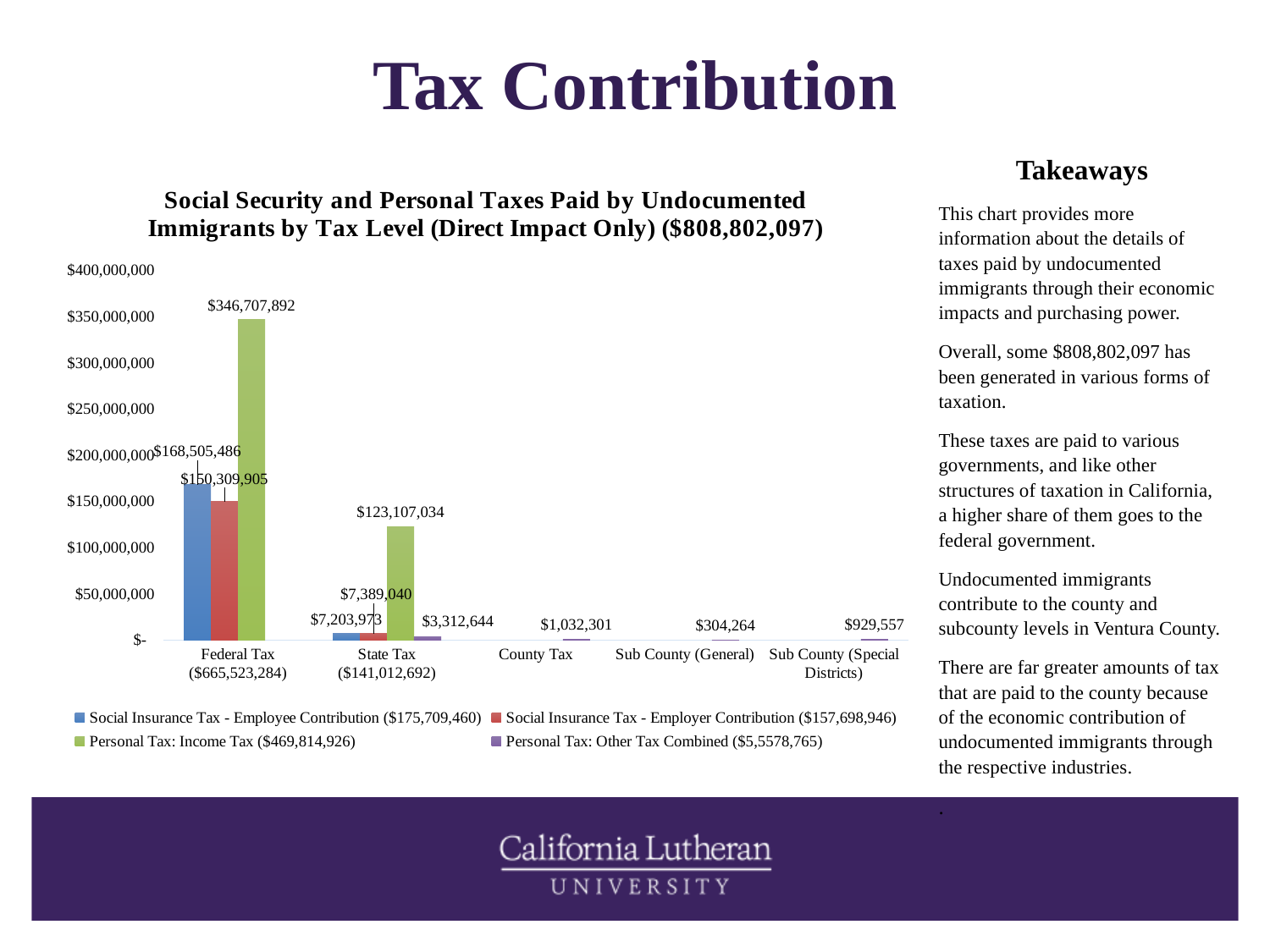
What is the difference between the Personal Tax: Income Tax and the Social Insurance Tax - Employee Contribution values for Federal Tax? $178,202,406 What value is labelled for County Tax? $1,032,301 Is the Personal Tax: Income Tax value for State Tax greater or less than $150,000,000? less What is the Social Insurance Tax - Employer Contribution value for State Tax? $7,389,040 What is the Social Insurance Tax - Employee Contribution value for Federal Tax? $168,505,486 What type of chart is shown on the slide? Bar chart Which is larger, the value for Sub County (Special Districts) or the value for Sub County (General)? Sub County (Special Districts) What is the Personal Tax: Income Tax value for State Tax? $123,107,034 Which tax level has the tallest bar in the chart? Federal Tax How many series does the legend list? 4 How many tax level categories are shown on the x axis? 5 What is the value of Personal Tax: Income Tax for Federal Tax? $346,707,892